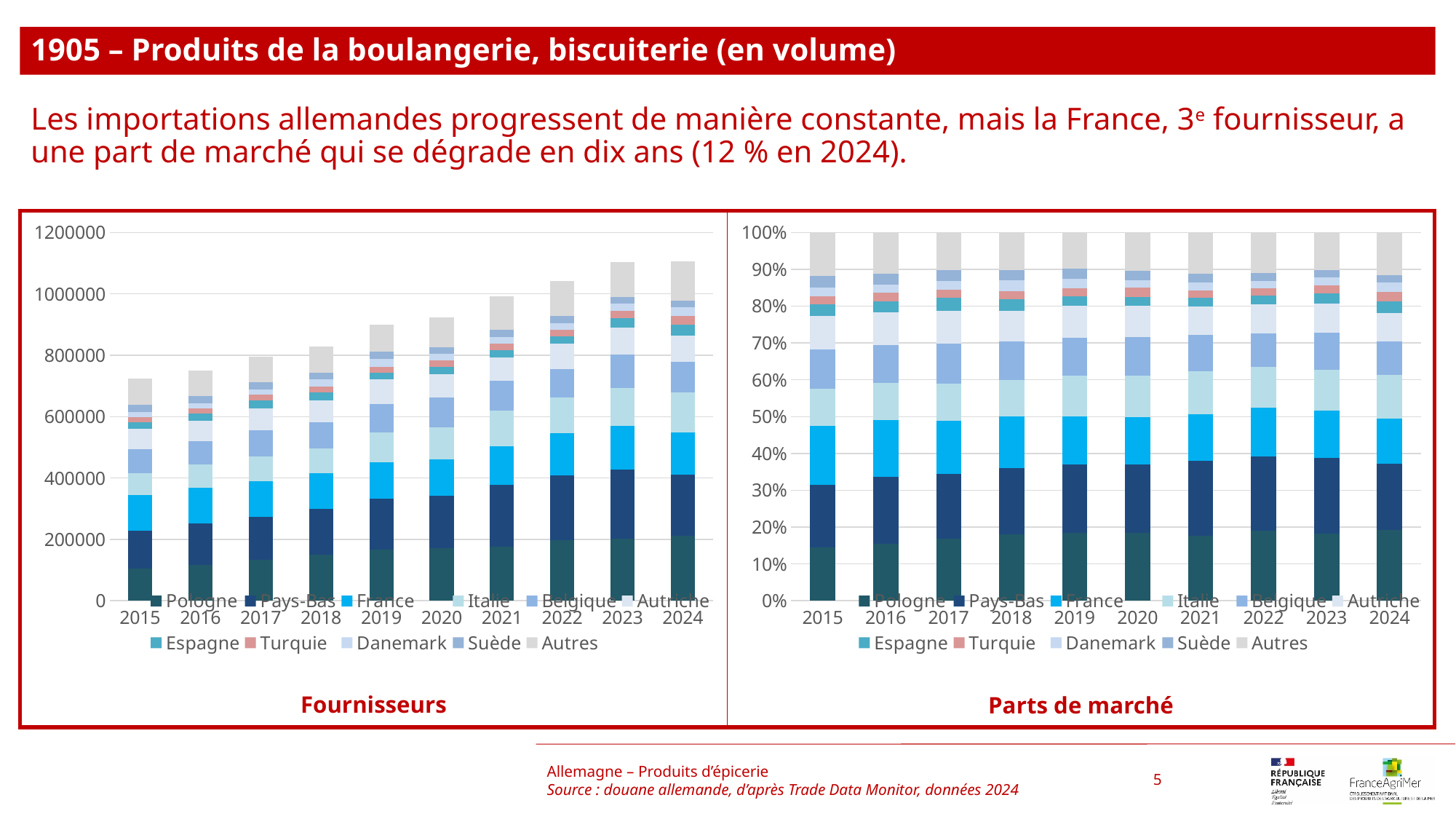
What is the title of the chart on the right side of the slide? Parts de marché In the 'Fournisseurs' chart, which year has the lowest total bar? 2015 What kind of chart is the 'Fournisseurs' chart? stacked bar chart In the 'Fournisseurs' chart, is the total bar for 2020 greater or less than 800000? greater How many years are shown on the x axis of the 'Parts de marché' chart? 10 In the 'Fournisseurs' chart, is the total bar for 2024 greater or less than 1000000? greater In the 'Parts de marché' chart, is the share for Pologne in 2015 greater or less than 20%? less In the 'Fournisseurs' chart, do the total bars generally rise or fall from 2015 to 2024? rise In the 'Fournisseurs' chart, which total bar is larger, 2015 or 2024? 2024 How many series does the legend of the 'Fournisseurs' chart list? 11